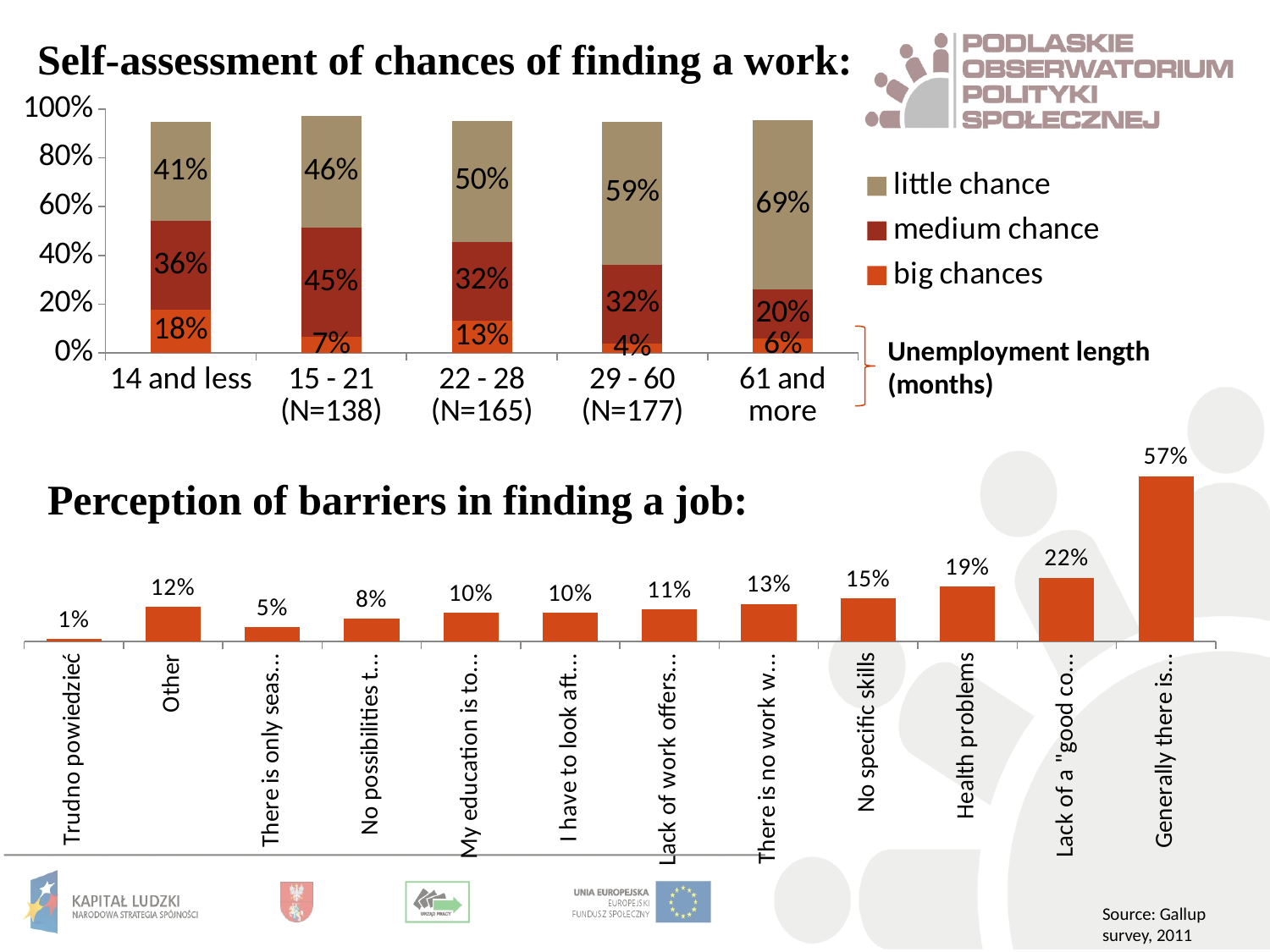
In the 'Perception of barriers in finding a job' chart, how many bars are plotted? 12 In the 'Perception of barriers in finding a job' chart, what is the value for 'Health problems'? 19% In the 'Self-assessment of chances of finding a work' chart, what is the 'little chance' value for the '61 and more' group? 69% In the 'Self-assessment of chances of finding a work' chart, which unemployment length group has the lowest 'big chances' value? 29 - 60 (N=177) In the 'Perception of barriers in finding a job' chart, which is larger: the value for 'Other' or the value for 'Health problems'? Health problems In the 'Self-assessment of chances of finding a work' chart, what is the 'medium chance' value for the '15 - 21 (N=138)' group? 45% In the 'Perception of barriers in finding a job' chart, what is the highest value shown? 57% In the 'Perception of barriers in finding a job' chart, what is the value for 'No specific skills'? 15% In the 'Self-assessment of chances of finding a work' chart, what is the difference between the 'little chance' values for the '61 and more' and '14 and less' groups? 28% In the 'Self-assessment of chances of finding a work' chart, what percentage of those unemployed 14 months and less report big chances? 18% In the 'Self-assessment of chances of finding a work' chart, how many series does the legend list? 3 In the 'Self-assessment of chances of finding a work' chart, does the 'little chance' share rise or fall as unemployment length increases? rise